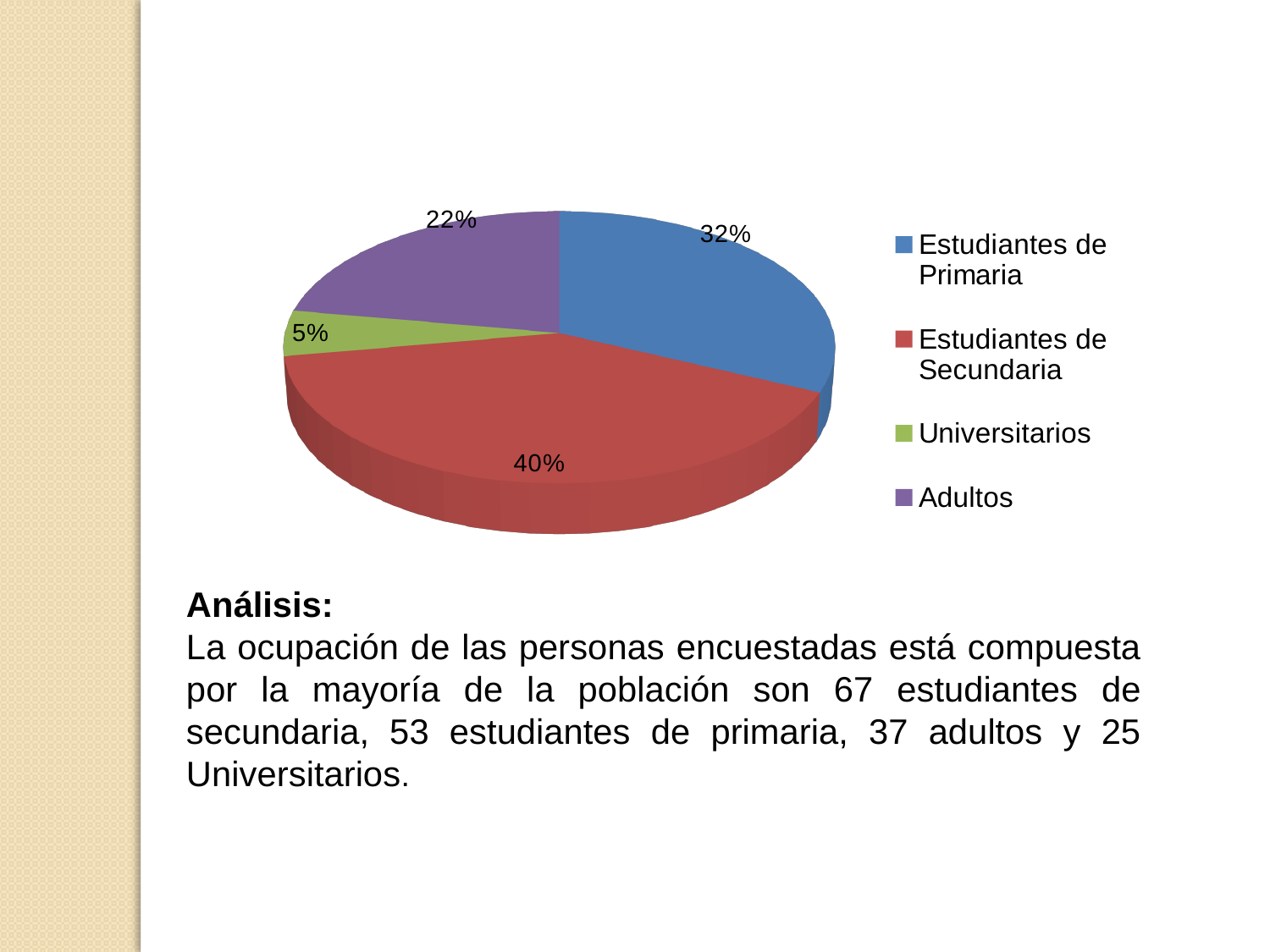
Which category has the smallest slice of the pie chart? Universitarios What kind of chart is shown on the slide? Pie chart How many categories does the pie chart show? 4 Which category has the largest slice of the pie chart? Estudiantes de Secundaria What is the difference in percentage points between Estudiantes de Secundaria and Estudiantes de Primaria? 8 What colour is the slice for Estudiantes de Secundaria? Red Which legend entry is shown in green? Universitarios What percentage of the pie chart is Estudiantes de Secundaria? 40% What percentage of the pie chart is Adultos? 22% What percentage of the pie chart is Universitarios? 5% Which is larger, the share for Adultos or the share for Universitarios? Adultos What percentage of the pie chart is Estudiantes de Primaria? 32%